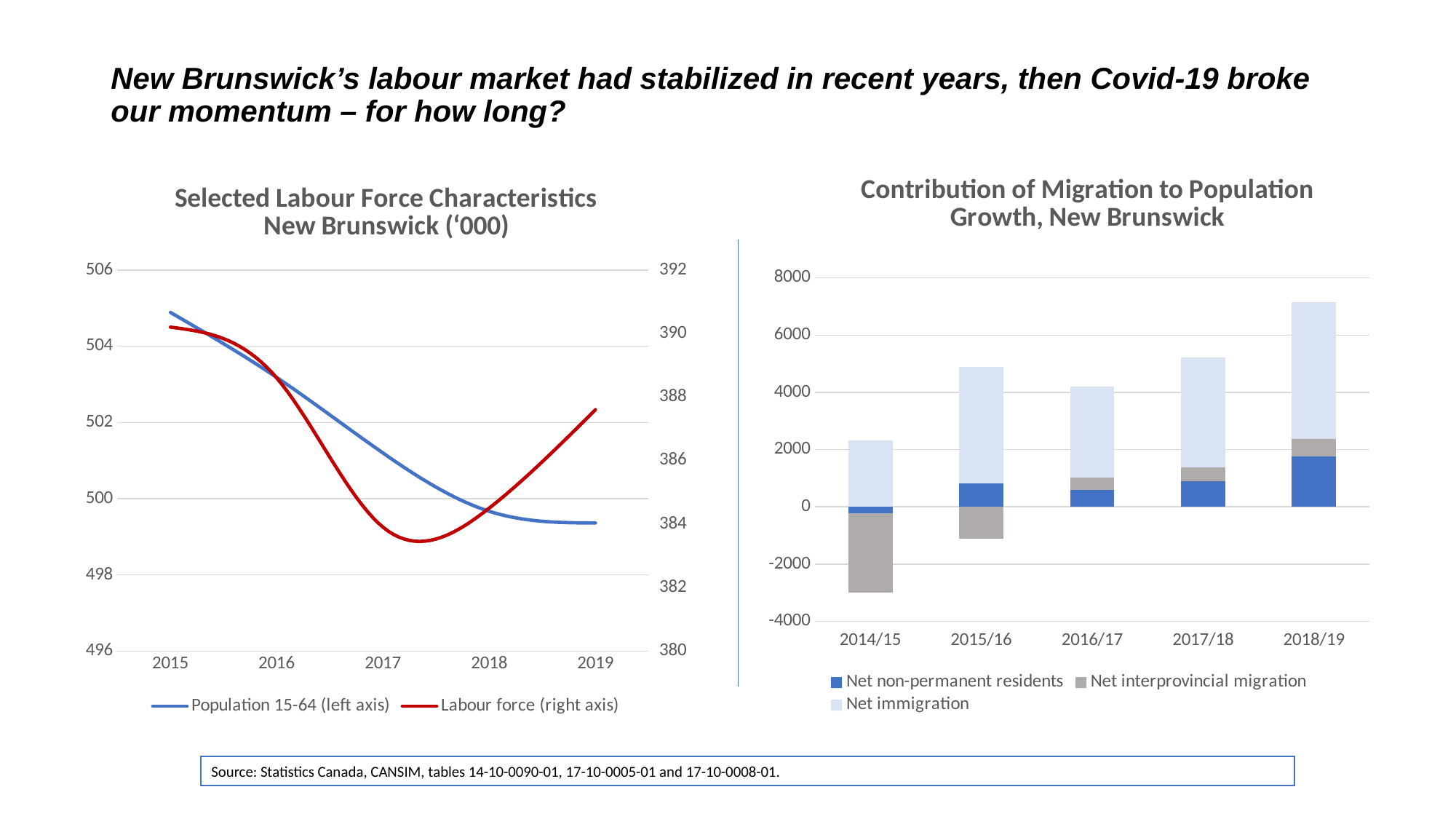
In the right chart, which year has the largest Net immigration segment? 2018/19 What kind of chart is the 'Contribution of Migration to Population Growth, New Brunswick' chart on the right? Stacked bar chart In the left chart, which series is plotted on the right axis? Labour force In the left chart, is the Population 15-64 value for 2019 greater or less than 500? less In the right chart, is Net interprovincial migration for 2014/15 greater or less than 0? less In the right chart, is the Net non-permanent residents segment larger in 2018/19 or in 2016/17? 2018/19 In the left chart, how many series does the legend list? 2 In the left chart, is the Labour force value for 2019 greater or less than 386? greater What kind of chart is the 'Selected Labour Force Characteristics New Brunswick' chart on the left? Line chart In the right chart, how many series does the legend list? 3 In the left chart, does Population 15-64 rise or fall from 2015 to 2019? Fall In the right chart, how many year categories are shown on the x axis? 5